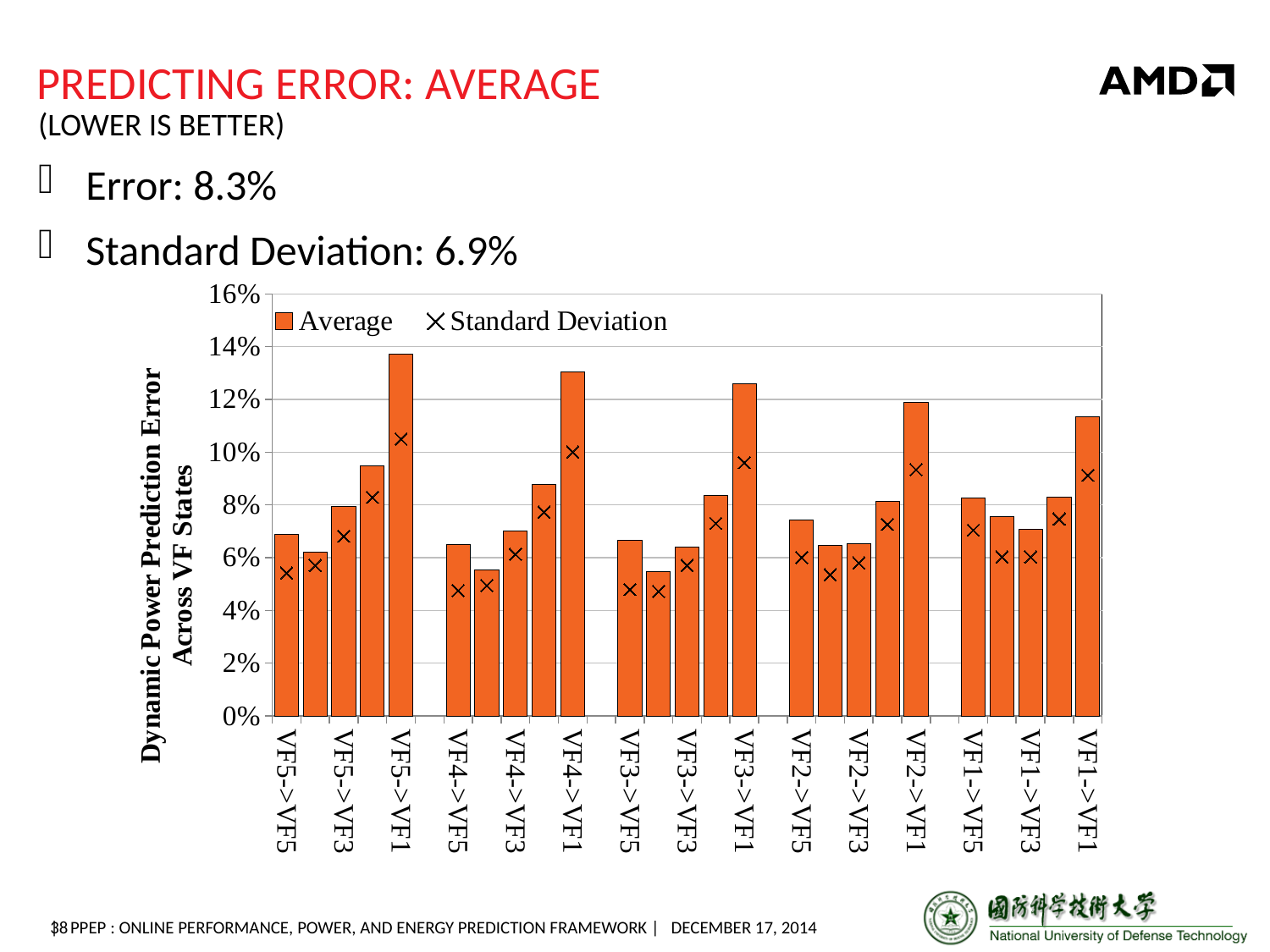
Is the Average value for VF1->VF1 greater or less than 10%? greater Is the Average value for VF5->VF1 greater or less than 12%? greater Is the Standard Deviation marker for VF5->VF1 greater or less than 10%? greater How many series does the chart legend list? 2 What is the title of the vertical axis of the chart? Dynamic Power Prediction Error Across VF States Which has the larger Average value, VF5->VF1 or VF1->VF1? VF5->VF1 Which category has the highest Average bar? VF5->VF1 What kind of chart is shown on the slide? bar chart Which has the larger Average value, VF5->VF3 or VF4->VF3? VF5->VF3 What are the two entries in the chart legend? Average and Standard Deviation